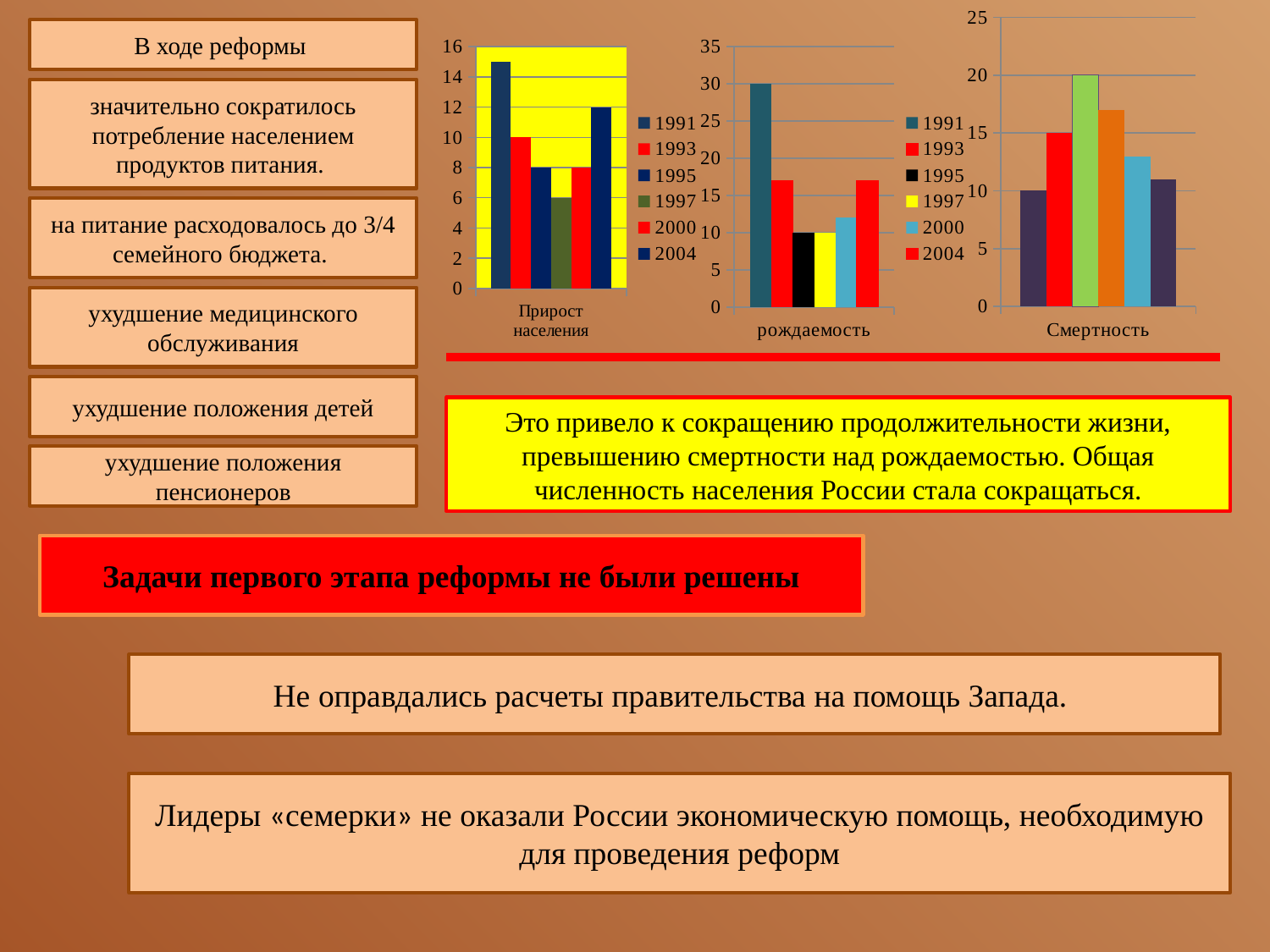
How many series does the legend of the "рождаемость" chart list? 6 In the "Прирост населения" chart, what is the difference between the values for 2004 and 1997? 6 In the "Прирост населения" chart, what is the value for 1993? 10 In the "рождаемость" chart, which year has the highest value? 1991 What kind of chart is the "Прирост населения" chart? bar chart In the "рождаемость" chart, is the value for 1993 greater or less than 15? greater In the "Прирост населения" chart, what is the value for 2004? 12 In the "рождаемость" chart, what is the value for 1991? 30 In the "Прирост населения" chart, which year has the lowest value? 1997 In the "Прирост населения" chart, is the value for 1991 greater or less than 14? greater